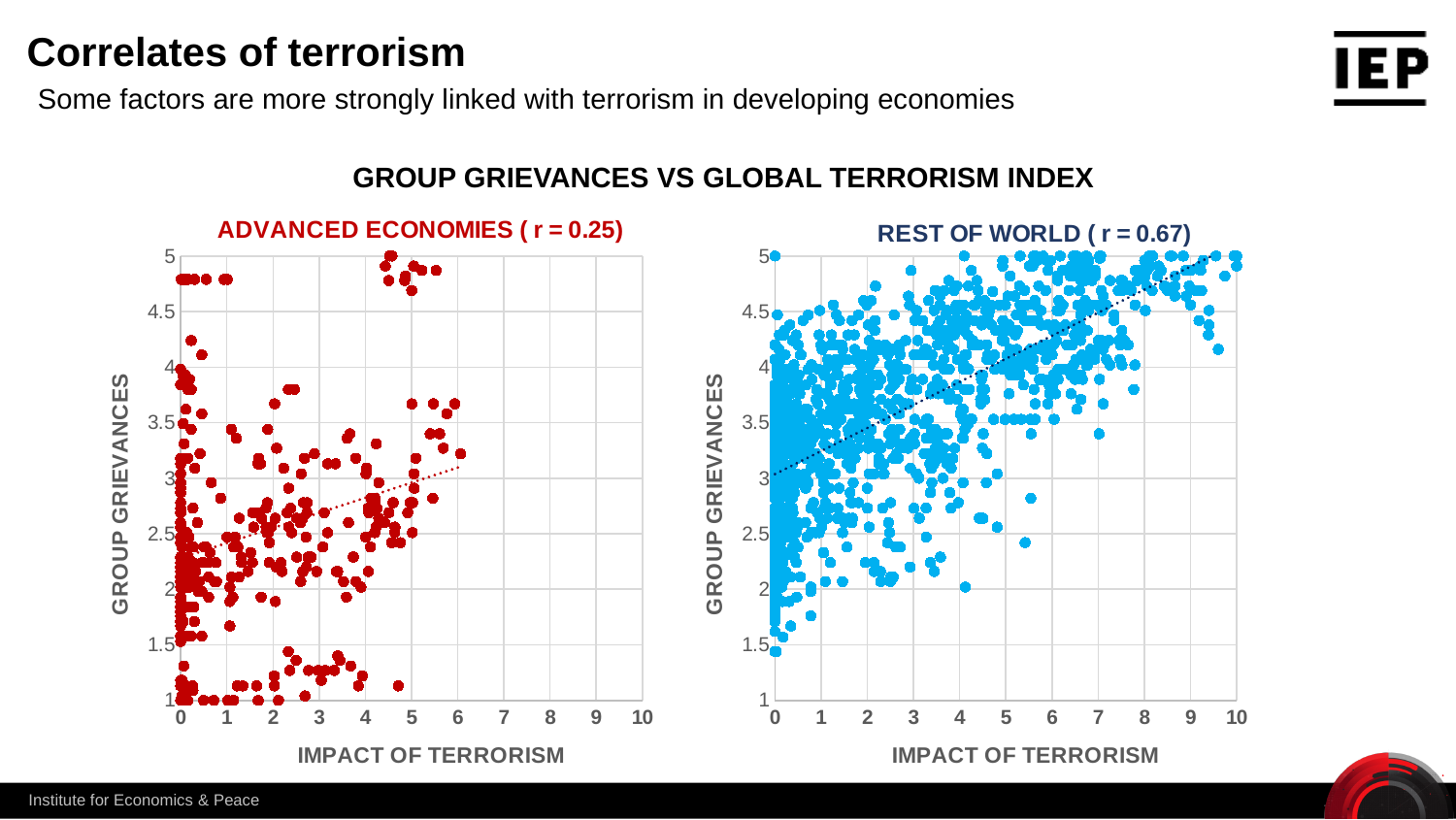
What label is shown on the y-axis of the Advanced Economies chart? GROUP GRIEVANCES What is the overall title shown above the two charts? GROUP GRIEVANCES VS GLOBAL TERRORISM INDEX What kind of chart is the Advanced Economies chart on the left? Scatter chart What correlation coefficient (r) is shown in the title of the Advanced Economies chart? 0.25 In the Advanced Economies chart, does the trend line rise or fall as Impact of Terrorism increases? Rise What correlation coefficient (r) is shown in the title of the Rest of World chart? 0.67 Is the correlation coefficient for the Advanced Economies chart greater or less than 0.5? Less In the Rest of World chart, does the trend line rise or fall as Impact of Terrorism increases? Rise What kind of chart is the Rest of World chart on the right? Scatter chart What is the difference between the correlation coefficients of the Rest of World chart and the Advanced Economies chart? 0.42 Which chart shows the higher correlation coefficient, Advanced Economies or Rest of World? Rest of World